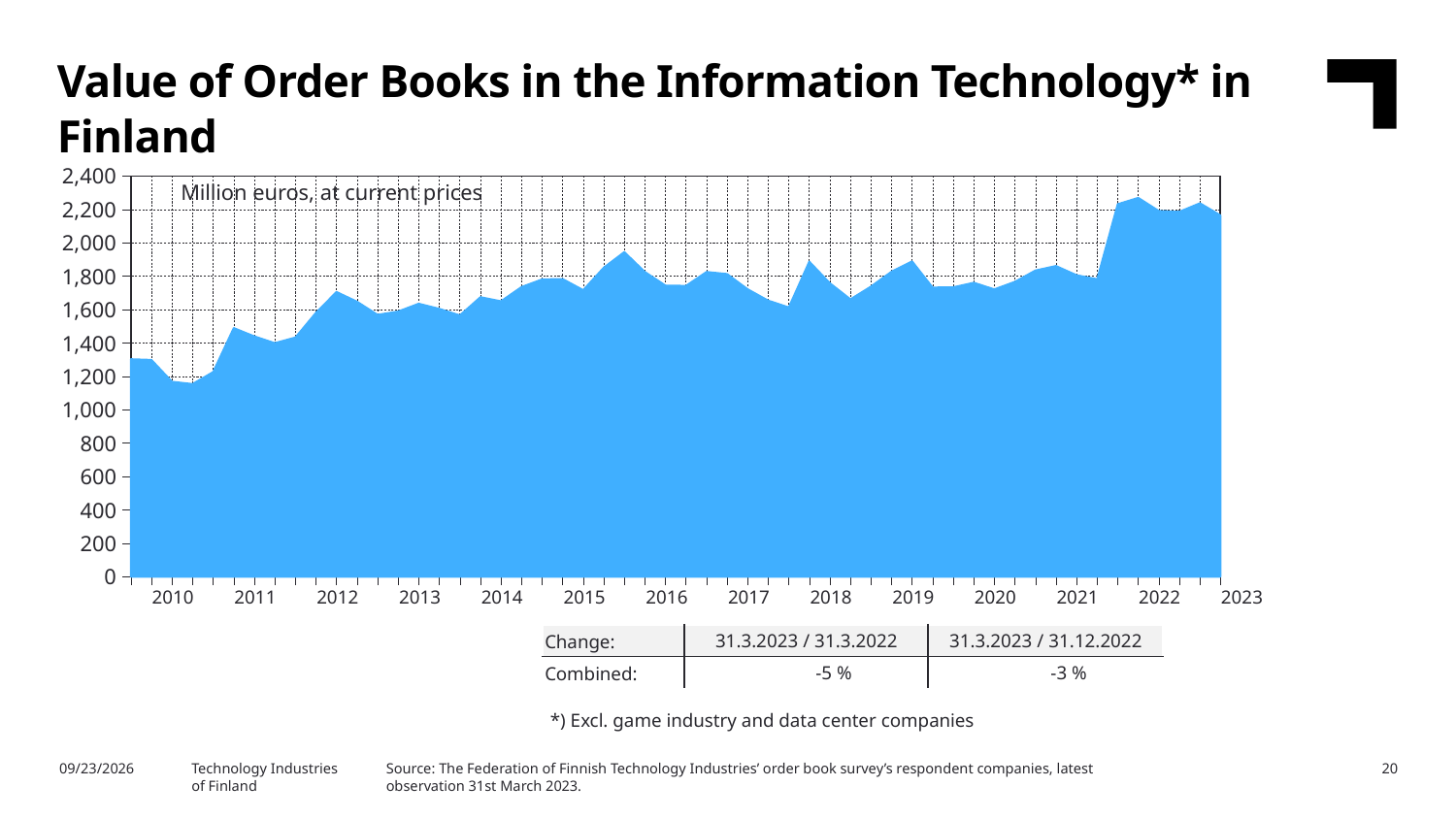
Is the value in 2020 greater or less than 2,000? less Overall, do the values rise or fall from 2010 to 2023? rise What is the combined change for 31.3.2023 / 31.12.2022 shown below the chart? -3 % In which year does the chart show its lowest value? 2010 What is the combined change for 31.3.2023 / 31.3.2022 shown below the chart? -5 % What unit is stated for the values in the chart? Million euros, at current prices What kind of chart is shown on the slide? Area chart Is the value at the start of 2022 greater or less than 2,000? greater What is the highest value shown on the vertical axis of the chart? 2,400 Is the value in 2015 greater or less than 1,600? greater In which year does the chart reach its highest value? 2022